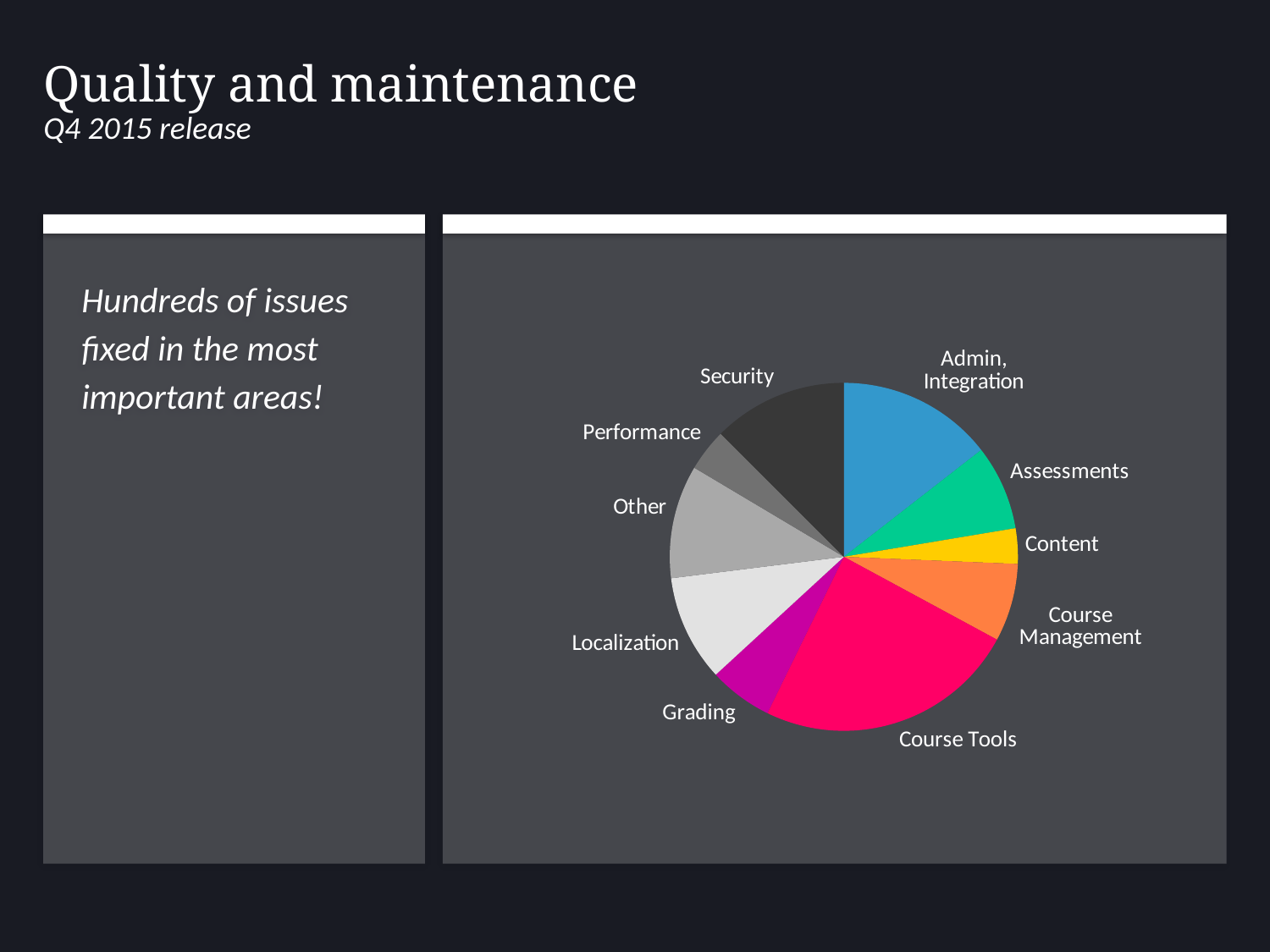
Which slice is larger, Other or Content? Other Which slice is larger, Course Tools or Grading? Course Tools Which slice is larger, Admin, Integration or Content? Admin, Integration Which category has the largest slice of the pie chart? Course Tools How many slices does the pie chart have? 10 What kind of chart is shown on the slide? pie chart What colour is the Course Tools slice? pink What colour is the Admin, Integration slice? blue